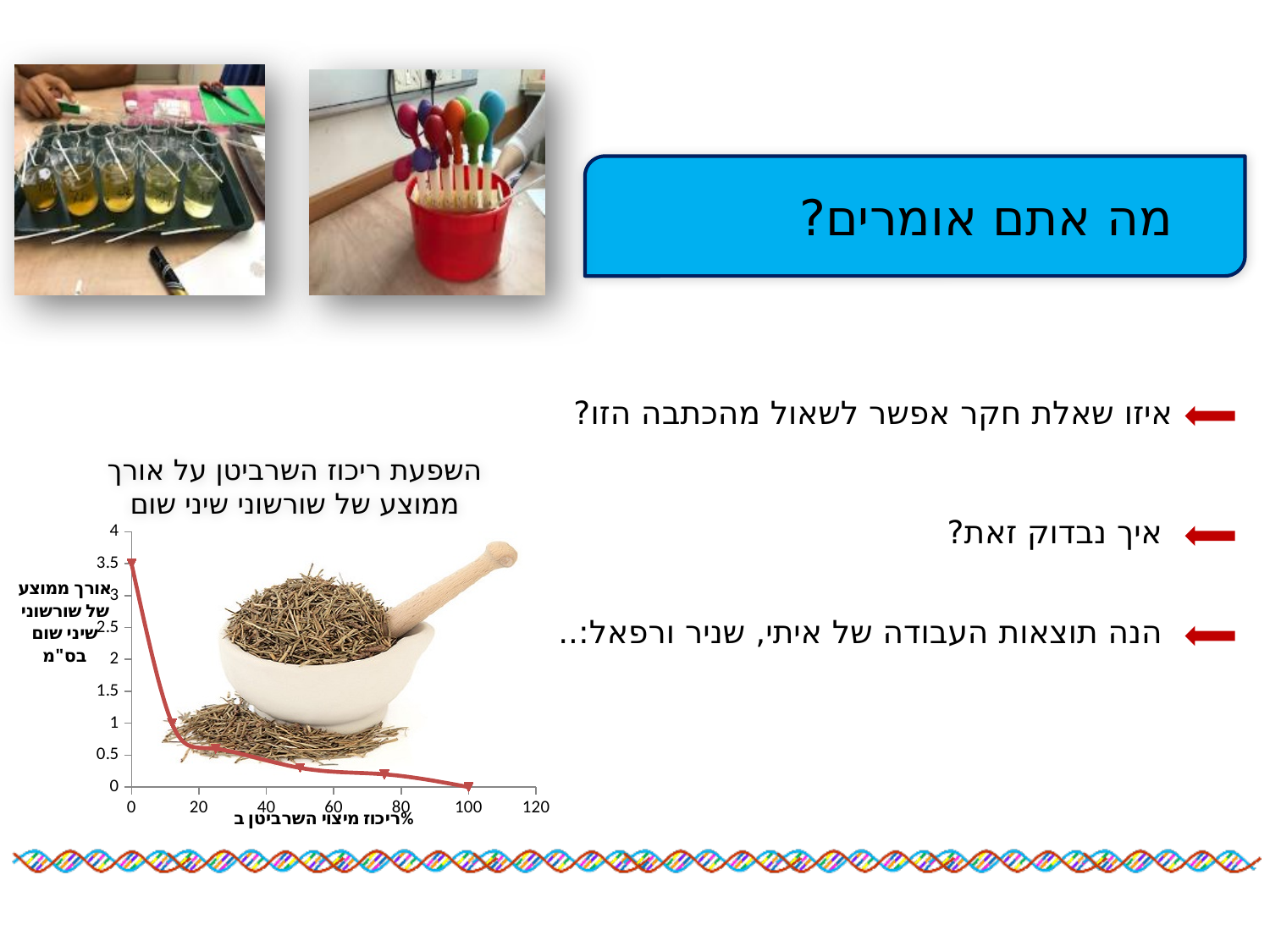
Is the average root length at a concentration of 0% greater or less than 3? greater Is the average root length at a concentration of 50% greater or less than 0.5? less How many data points are plotted on the chart? 6 At which concentration is the average root length highest? 0 What is the average root length at a concentration of 0%? 3.5 What kind of chart is shown on the slide? line chart What is the label of the x axis of the chart? ריכוז מיצוי השרביטן ב% What is the average root length at a concentration of 100%? 0 What is the title of the chart? השפעת ריכוז השרביטן על אורך ממוצע של שורשוני שיני שום Which has a larger average root length: concentration 0% or concentration 100%? 0% At which concentration is the average root length lowest? 100 Do the values rise or fall as the concentration on the x axis increases? fall